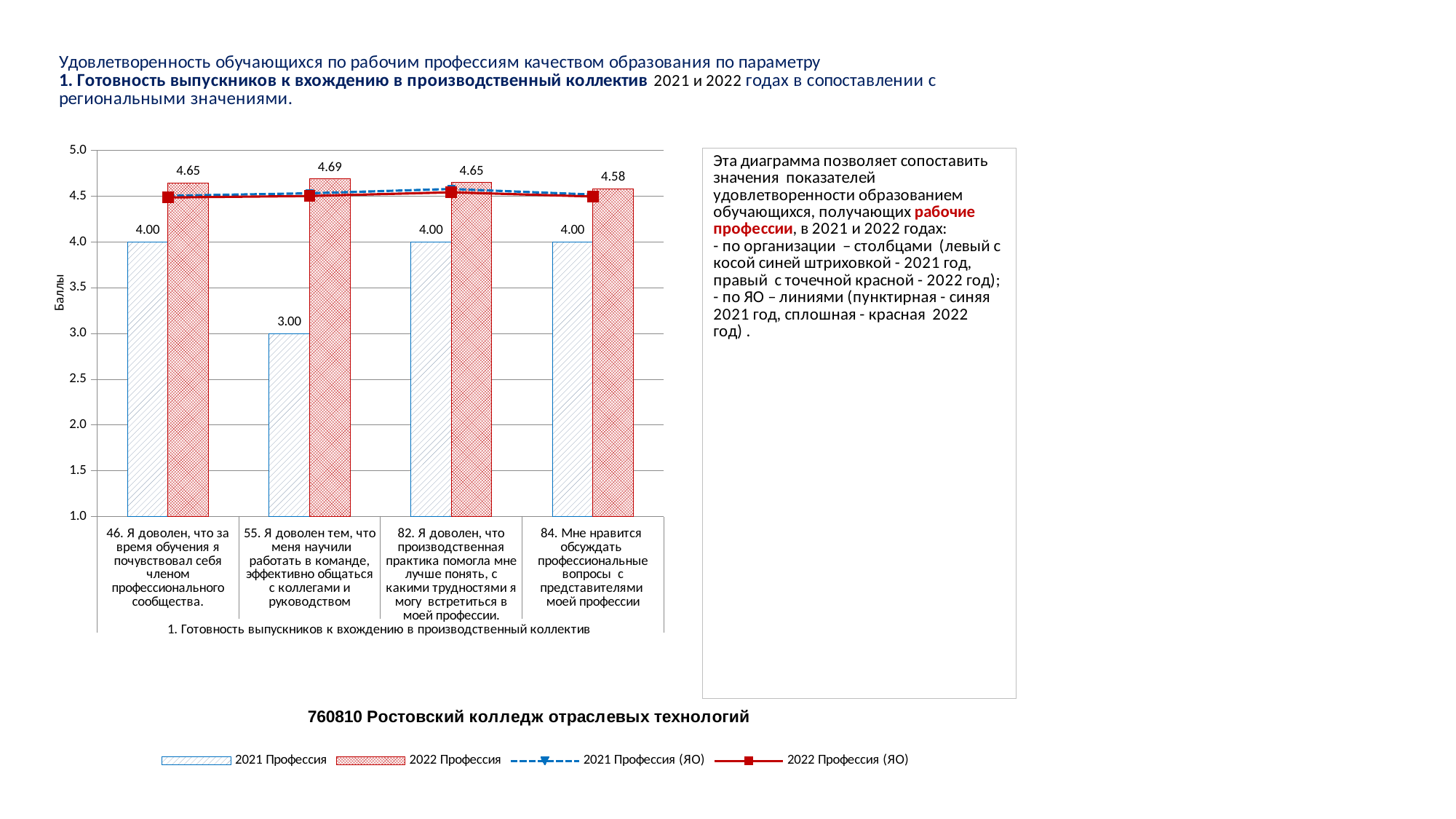
How many categories are shown on the x axis of the chart? 4 What is the difference between the 2022 Профессия and 2021 Профессия values for category 55? 1.69 For category 82, which is larger: the 2021 Профессия bar or the 2022 Профессия bar? 2022 Профессия What is the difference between the 2022 Профессия and 2021 Профессия values for category 84? 0.58 What is the value of the 2021 Профессия bar for category 55 (Я доволен тем, что меня научили работать в команде...)? 3.00 What is the label of the vertical axis of the chart? Баллы What is the value of the 2022 Профессия bar for category 84 (Мне нравится обсуждать профессиональные вопросы...)? 4.58 How many series does the chart legend list? 4 What is the value of the 2022 Профессия bar for category 46 (Я доволен, что за время обучения я почувствовал себя членом профессионального сообщества)? 4.65 Is the 2021 Профессия (ЯО) line value for category 46 greater or less than 4.0? greater Which category has the lowest 2021 Профессия value? 55. Я доволен тем, что меня научили работать в команде, эффективно общаться с коллегами и руководством Which category has the highest 2022 Профессия value? 55. Я доволен тем, что меня научили работать в команде, эффективно общаться с коллегами и руководством